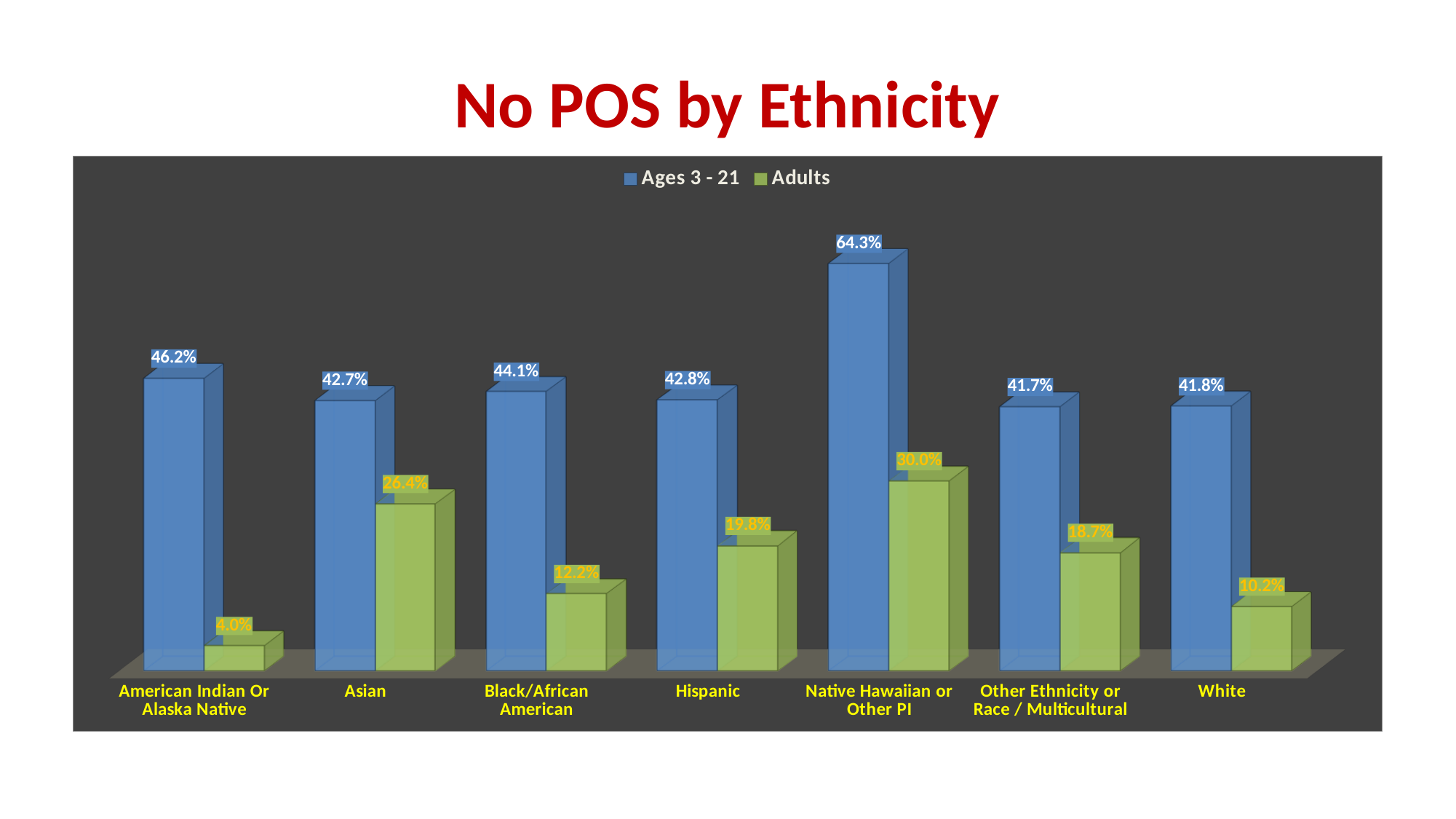
Which ethnicity has the lowest Adults value? American Indian Or Alaska Native What is the title of the slide? No POS by Ethnicity Which colour represents the Adults series? Green What is the Adults value for American Indian Or Alaska Native? 4.0% Which ethnicity has the highest Ages 3 - 21 value? Native Hawaiian or Other PI What kind of chart is shown on the slide? Bar chart How many series does the legend list? 2 What is the Adults value for Asian? 26.4% Which is larger, the Adults value for Hispanic or the Adults value for Other Ethnicity or Race / Multicultural? Hispanic What is the difference between the Ages 3 - 21 and Adults values for White? 31.6% How many ethnicity categories are shown on the chart? 7 What is the Ages 3 - 21 value for Native Hawaiian or Other PI? 64.3%